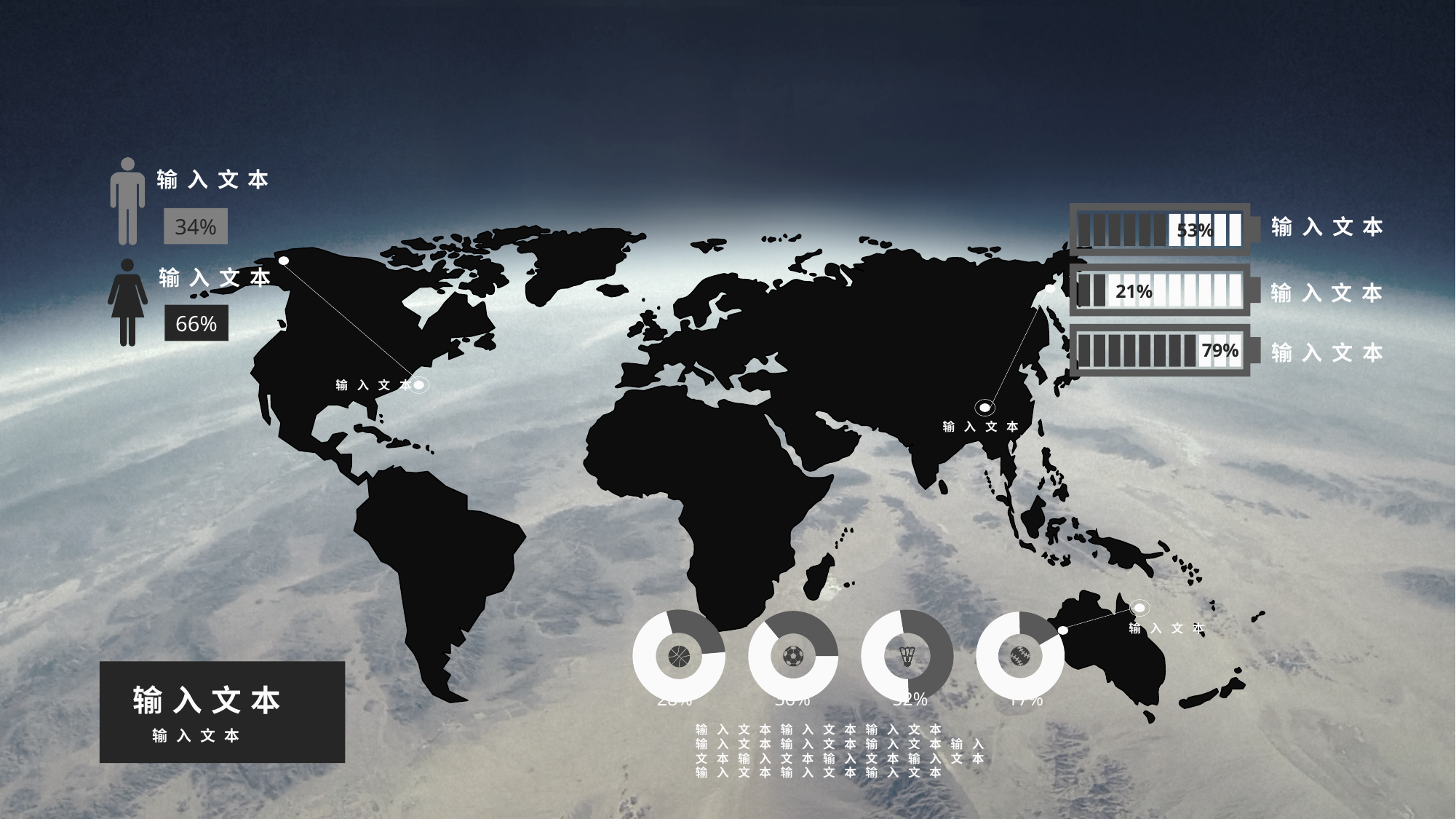
Which of the three battery gauges on the right shows the highest percentage? the bottom one (79%) How many donut charts are shown along the bottom of the slide? 4 What percentage is shown in the bottom battery gauge on the right of the slide? 79% What percentage is shown next to the male figure icon on the left of the slide? 34% Which of the three battery gauges on the right shows the lowest percentage? the middle one (21%) What percentage is shown next to the female figure icon on the left of the slide? 66% What percentage is shown in the top battery gauge on the right of the slide? 53% What is the difference between the female figure's percentage and the male figure's percentage on the left of the slide? 32 percentage points What percentage is shown in the middle battery gauge on the right of the slide? 21% How many battery gauges are shown on the right side of the slide? 3 Which of the two figure icons on the left has the larger percentage, the male or the female? female What is the difference between the bottom battery gauge's percentage and the middle battery gauge's percentage? 58 percentage points